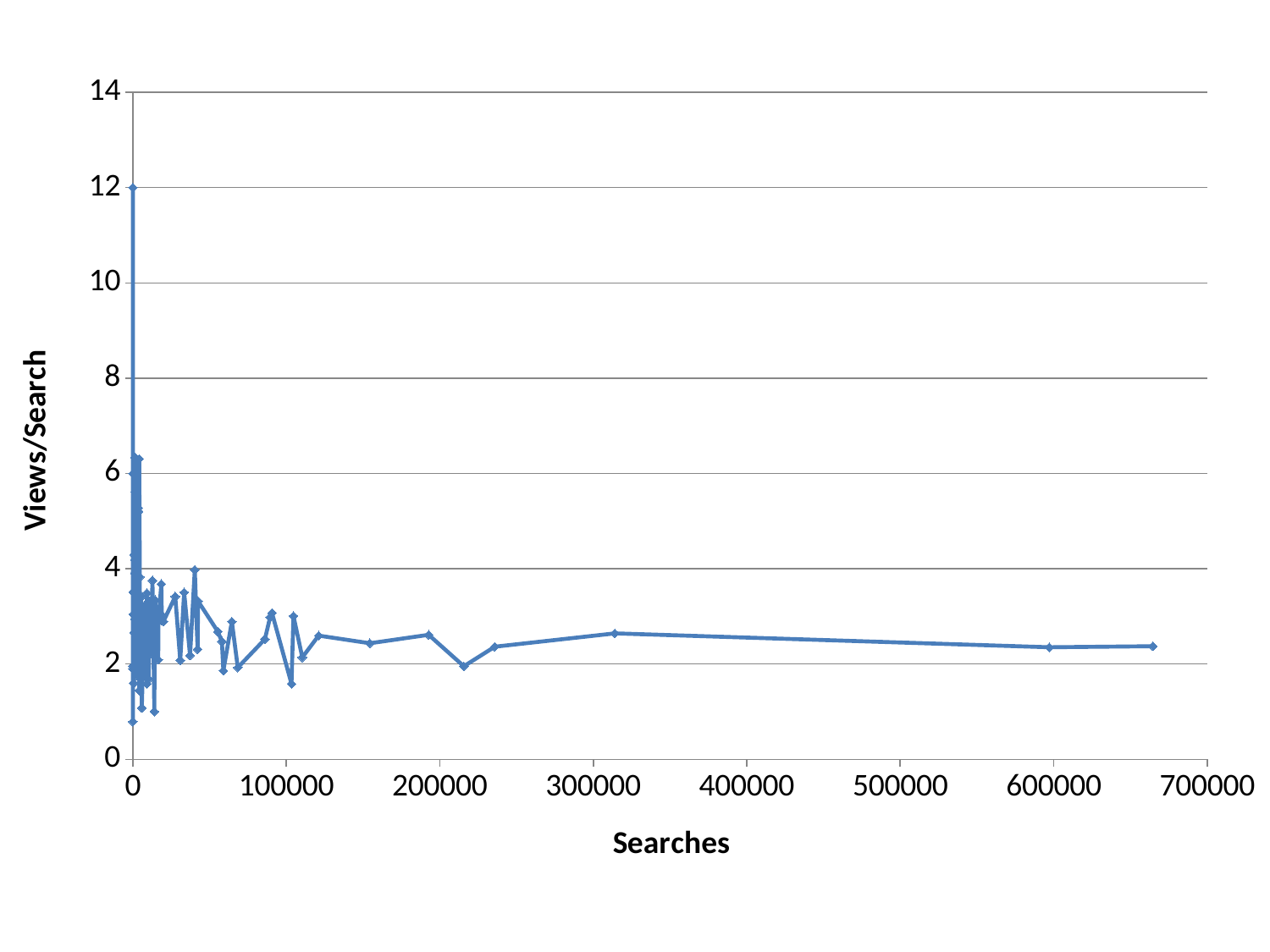
What is the title of the x axis? Searches Is the highest Views/Search value on the chart greater or less than 10? greater Is the Views/Search value at the rightmost point (around 660000 searches) greater or less than 4? less What kind of chart is shown on the slide? line chart As the number of searches increases along the x axis, do the Views/Search values become more variable or less variable? less variable What is the highest tick value shown on the y axis? 14 Is the Views/Search value at roughly 600000 searches greater or less than 6? less What is the title of the y axis? Views/Search